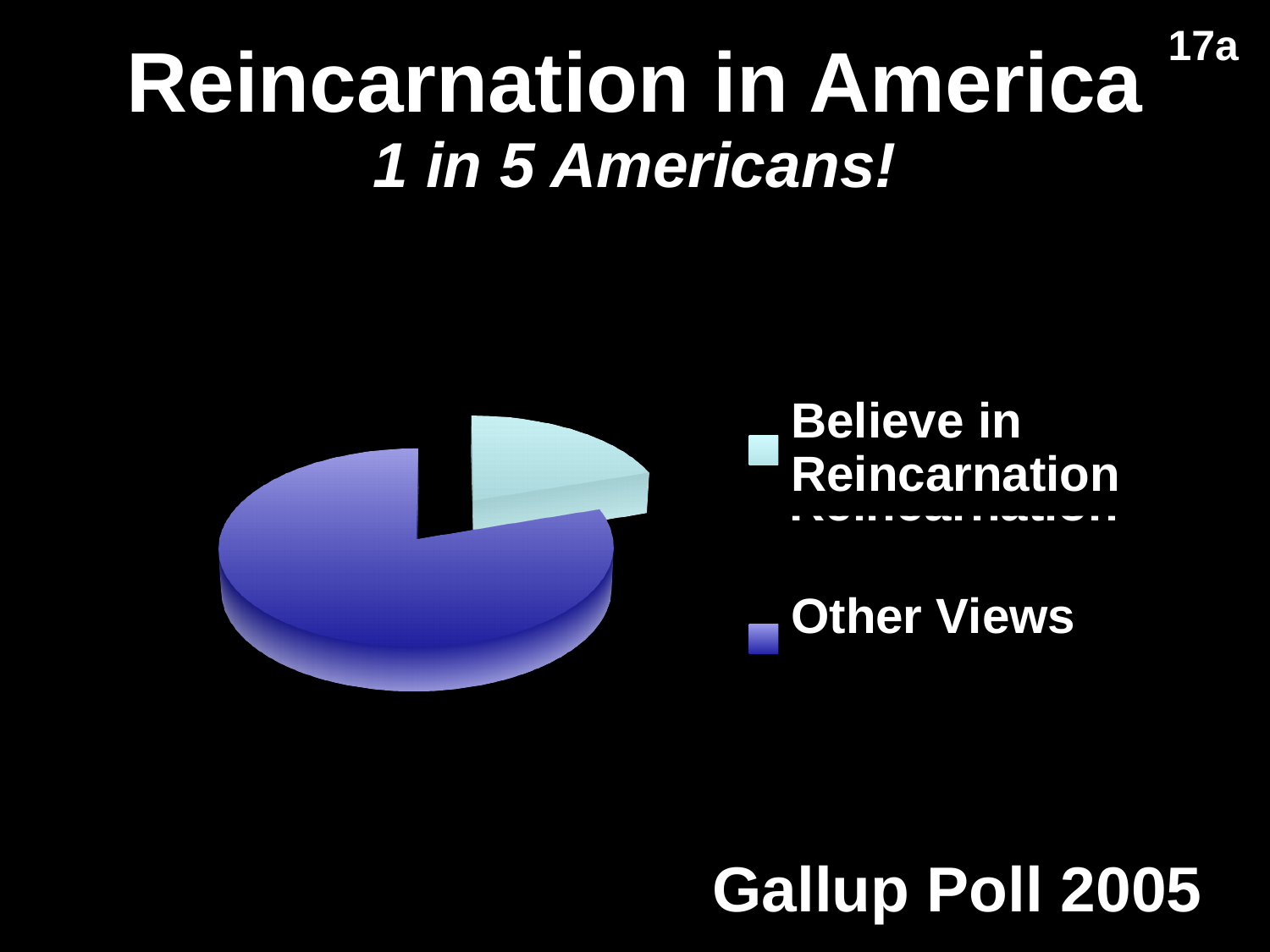
How many slices does the pie chart have? 2 How many entries does the legend of the pie chart list? 2 Which legend entry is shown in light blue in the pie chart? Believe in Reincarnation What is the title of the slide containing the pie chart? Reincarnation in America Which slice of the pie chart is the largest? Other Views Which slice of the pie chart is the smallest? Believe in Reincarnation What kind of chart is shown on the slide? pie chart Which slice is larger in the pie chart, Believe in Reincarnation or Other Views? Other Views